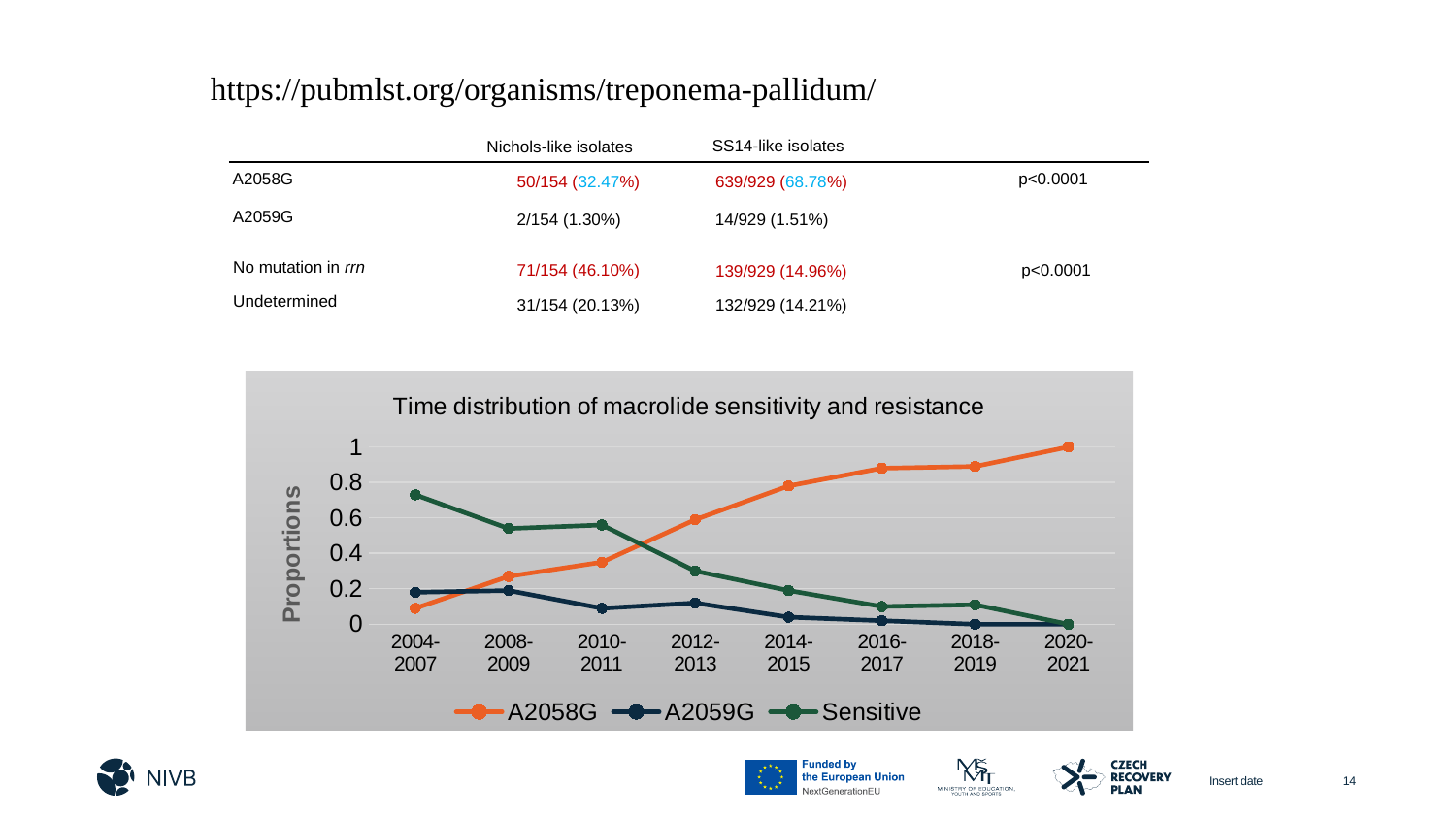
How many time periods are shown on the x axis of the chart? 8 Does the Sensitive line rise or fall from 2004-2007 to 2020-2021? fall Is the Sensitive proportion for 2004-2007 greater or less than 0.6? greater How many series does the legend of the chart list? 3 In which period is the Sensitive proportion highest? 2004-2007 What is the title of the chart? Time distribution of macrolide sensitivity and resistance In which period is the A2058G proportion highest? 2020-2021 In 2012-2013, which is larger: the A2058G proportion or the Sensitive proportion? A2058G Is the A2058G proportion for 2016-2017 greater or less than 0.8? greater Is the A2058G proportion for 2004-2007 greater or less than 0.2? less Does the A2058G line rise or fall from 2004-2007 to 2020-2021? rise What kind of chart is shown on the slide? line chart